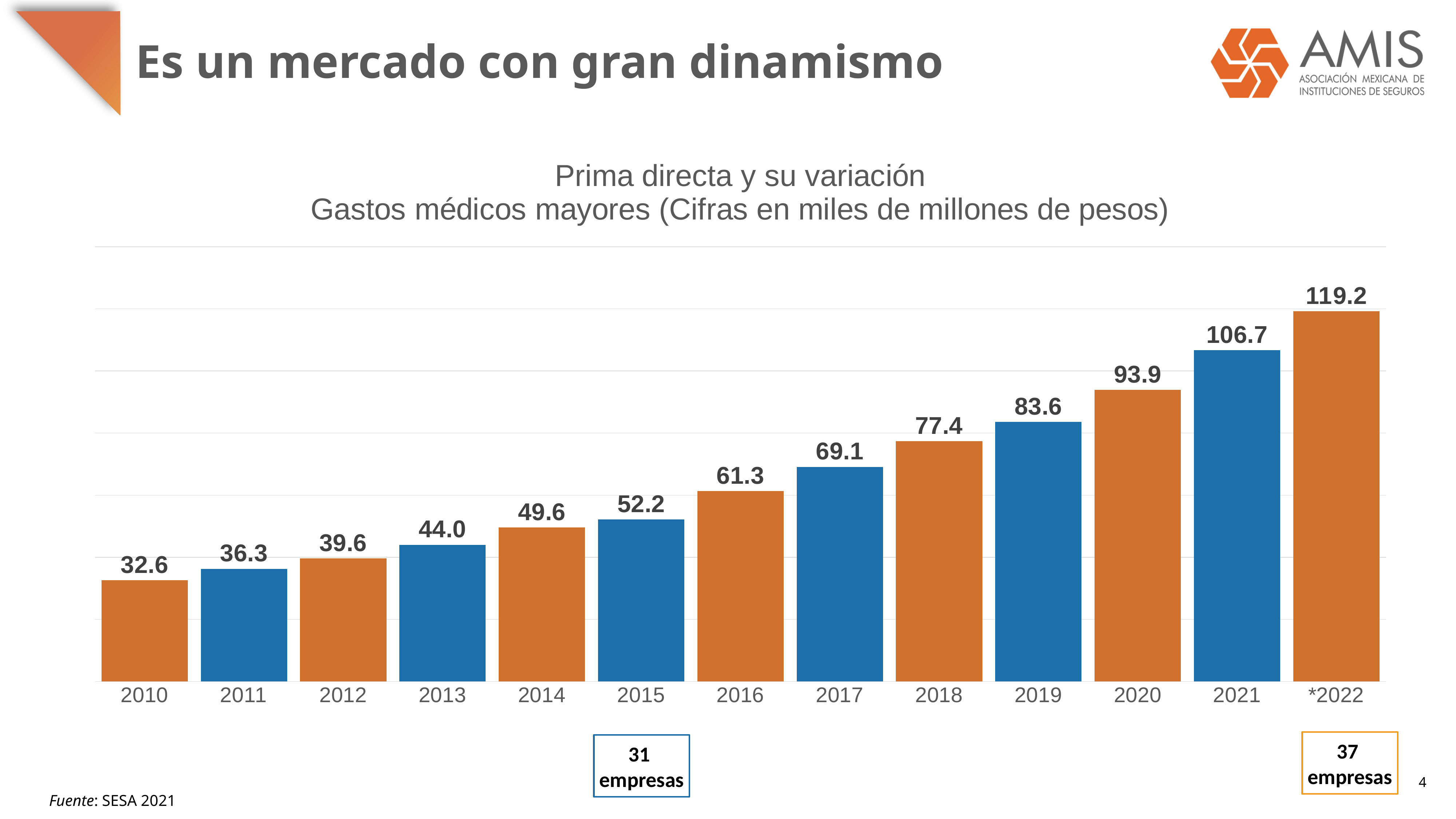
Which is larger, the value for 2017 or the value for 2016? 2017 Which year has the lowest value? 2010 What is the difference between the values for 2021 and 2020? 12.8 What is the difference between the values for *2022 and 2010? 86.6 How many years are shown on the x axis? 13 Which year has the highest value? *2022 What kind of chart is shown? bar chart What is the value for 2015? 52.2 Do the values rise or fall from 2010 to *2022? rise What is the title of the chart? Prima directa y su variación Gastos médicos mayores (Cifras en miles de millones de pesos) What is the value for 2020? 93.9 What is the value for 2010? 32.6